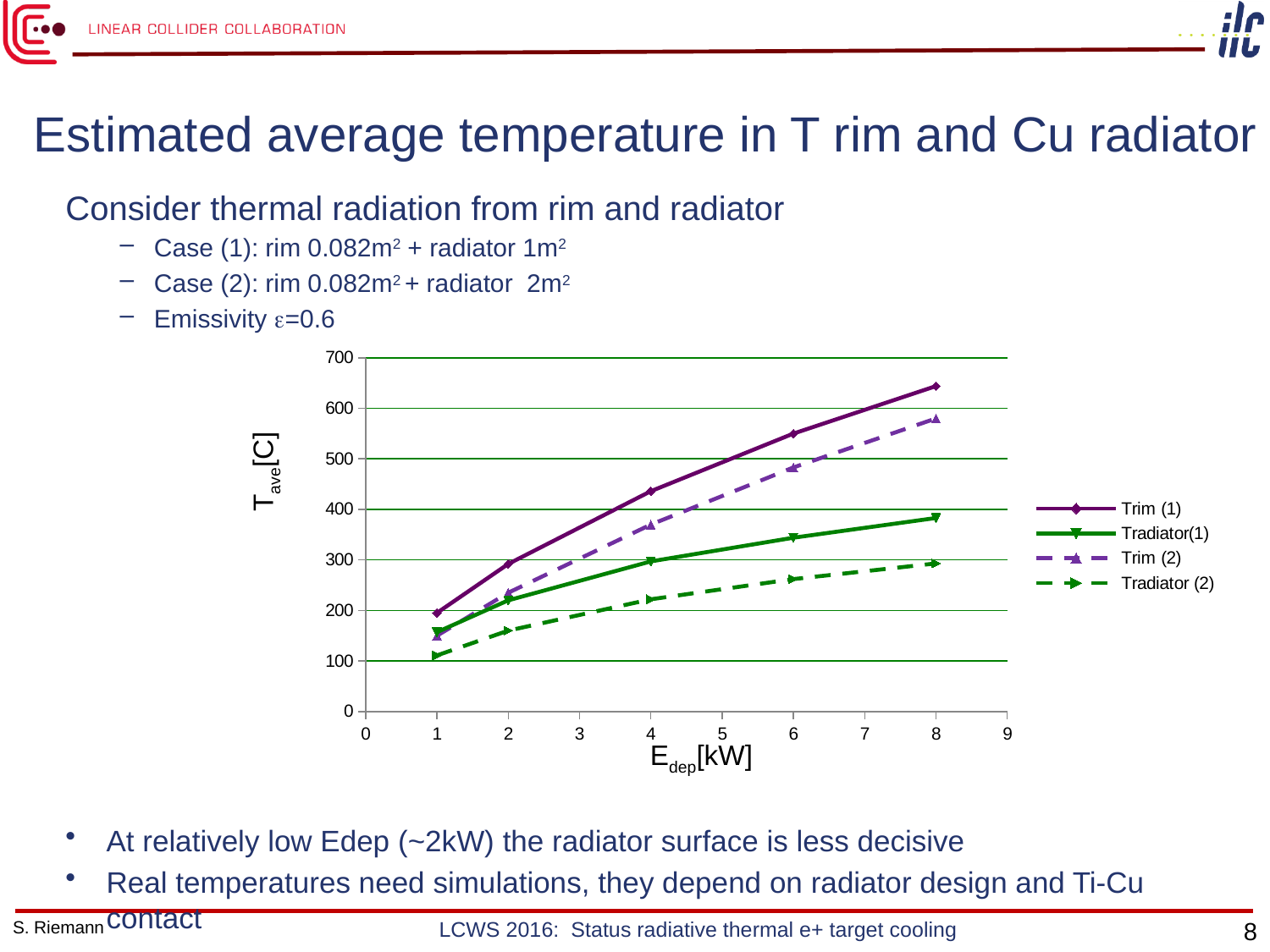
Which series has the lowest value at E_dep = 8 kW? Tradiator (2) Is the value of Trim (2) at E_dep = 4 kW greater or less than 400? less Is the value of Trim (1) at E_dep = 8 kW greater or less than 600? greater Does the Trim (1) series rise or fall as E_dep increases? rises How many data points are plotted for the Trim (1) series? 5 Which series has the highest value at E_dep = 8 kW? Trim (1) What kind of chart is shown on the slide? line chart How many series does the legend list? 4 Which series are drawn with dashed lines? Trim (2) and Tradiator (2) At E_dep = 6 kW, which is larger: Trim (2) or Tradiator(1)? Trim (2) What is the label of the x axis? E_dep[kW]